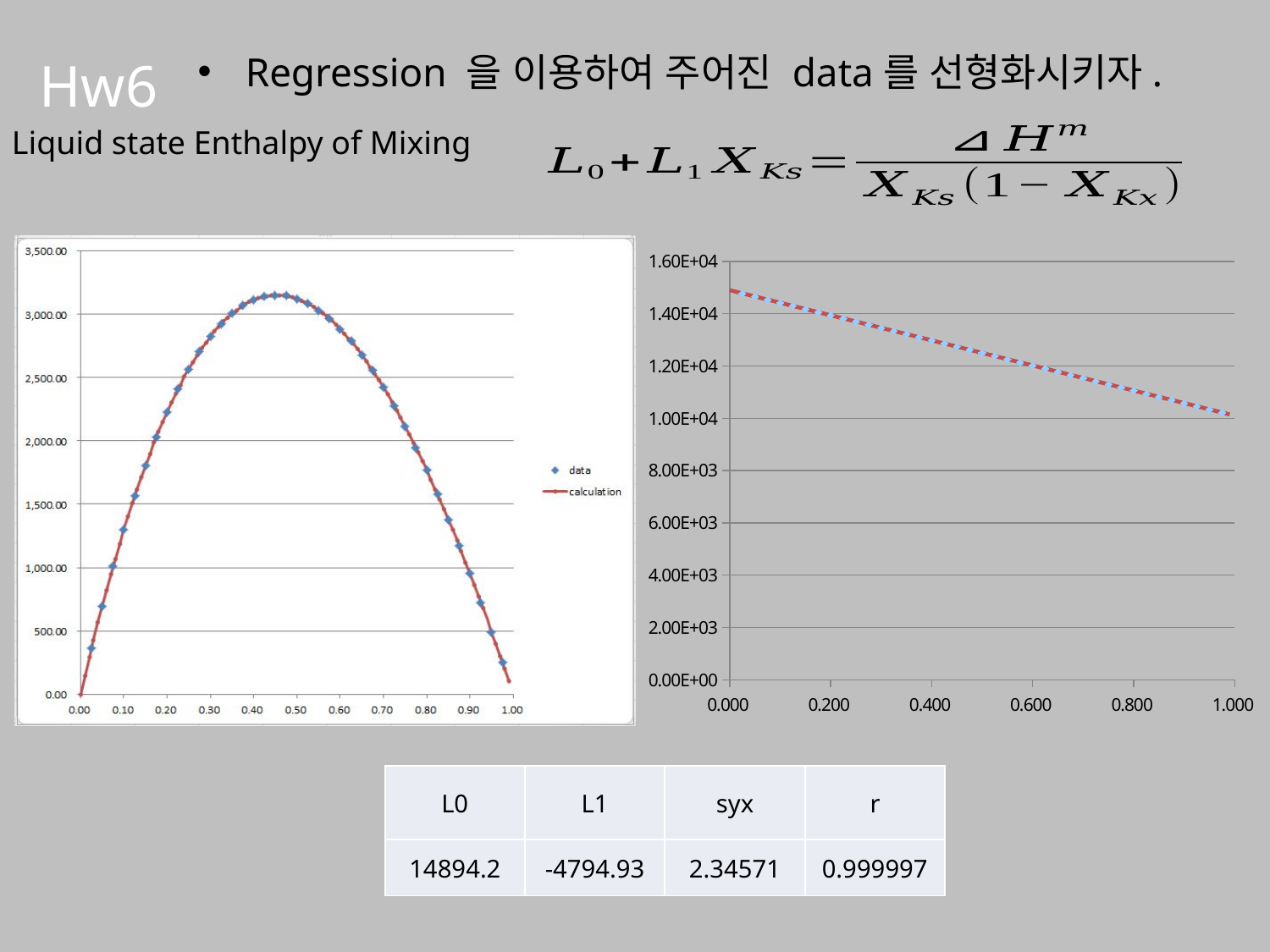
In the right chart, do the values rise or fall as x increases from 0.000 to 1.000? fall In the left chart, is the value at x = 0.90 greater or less than 1,000.00? less In the left chart, is the value at x = 0.50 greater or less than 3,000.00? greater What is the highest tick label on the y axis of the left chart? 3,500.00 What are the two series names in the legend of the left chart? data, calculation What kind of chart is the right chart? line chart How many series does the legend of the left chart list? 2 In the left chart, do the values rise or fall as x goes from 0.00 to 0.40? rise What kind of chart is the left chart (Liquid state Enthalpy of Mixing)? line chart with scatter points In the left chart, do the values rise or fall as x goes from 0.60 to 1.00? fall In the right chart, is the value at x = 0.000 greater or less than 1.40E+04? greater